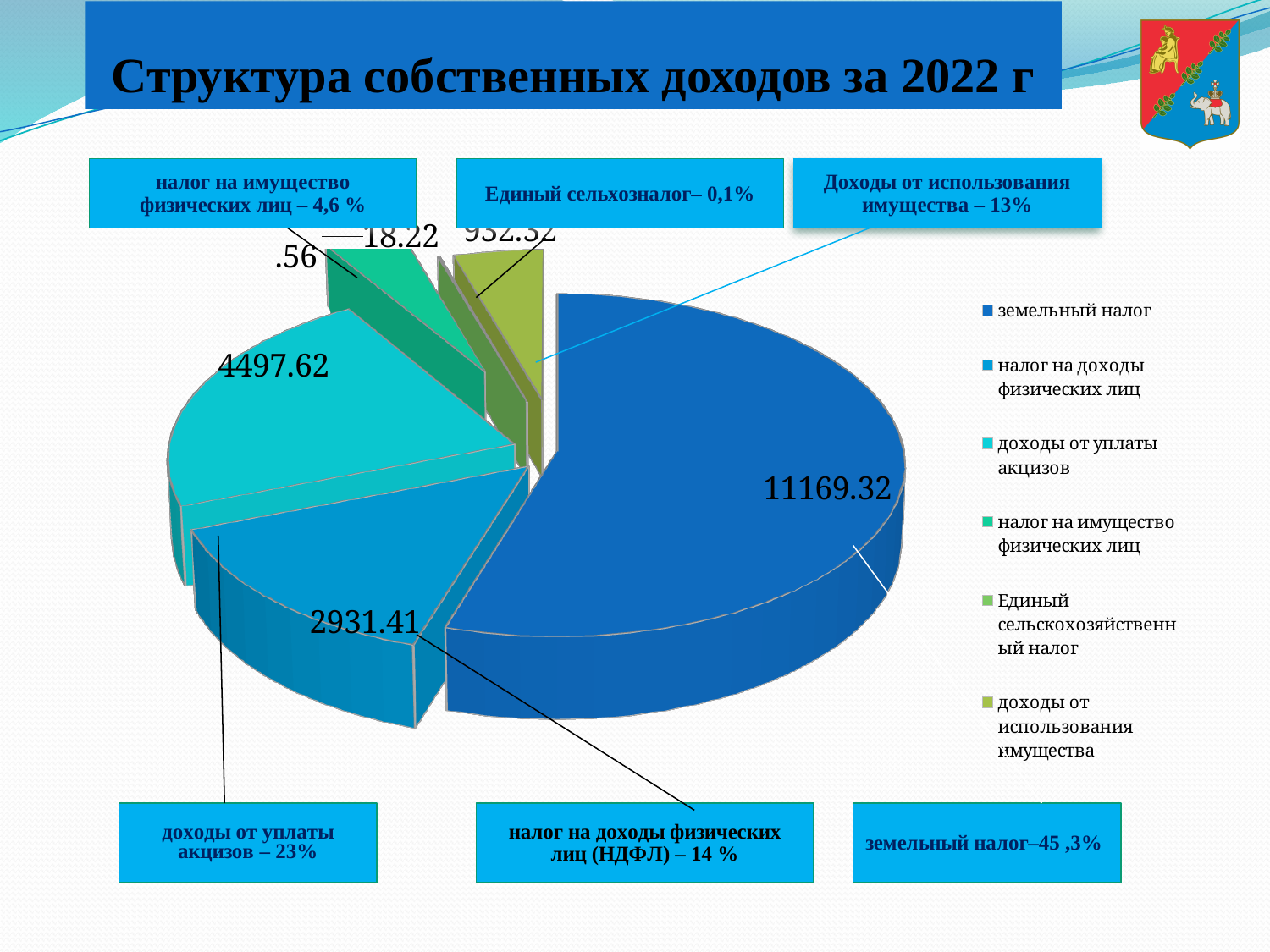
What is the value shown for доходы от уплаты акцизов? 4497.62 What is the value shown for земельный налог? 11169.32 What share of the pie does земельный налог represent, according to the callout on the slide? 45,3% Which is larger: доходы от уплаты акцизов or налог на доходы физических лиц? доходы от уплаты акцизов How many categories does the legend of the pie chart list? 6 What kind of chart is shown on the slide? pie chart What is the difference between the values for доходы от уплаты акцизов and налог на доходы физических лиц? 1566.21 What share of the pie does доходы от использования имущества represent, according to the callout on the slide? 13% Which category has the largest slice of the pie? земельный налог What is the value shown for налог на доходы физических лиц? 2931.41 Which category has the smallest slice of the pie? Единый сельскохозяйственный налог What is the title of the chart on the slide? Структура собственных доходов за 2022 г